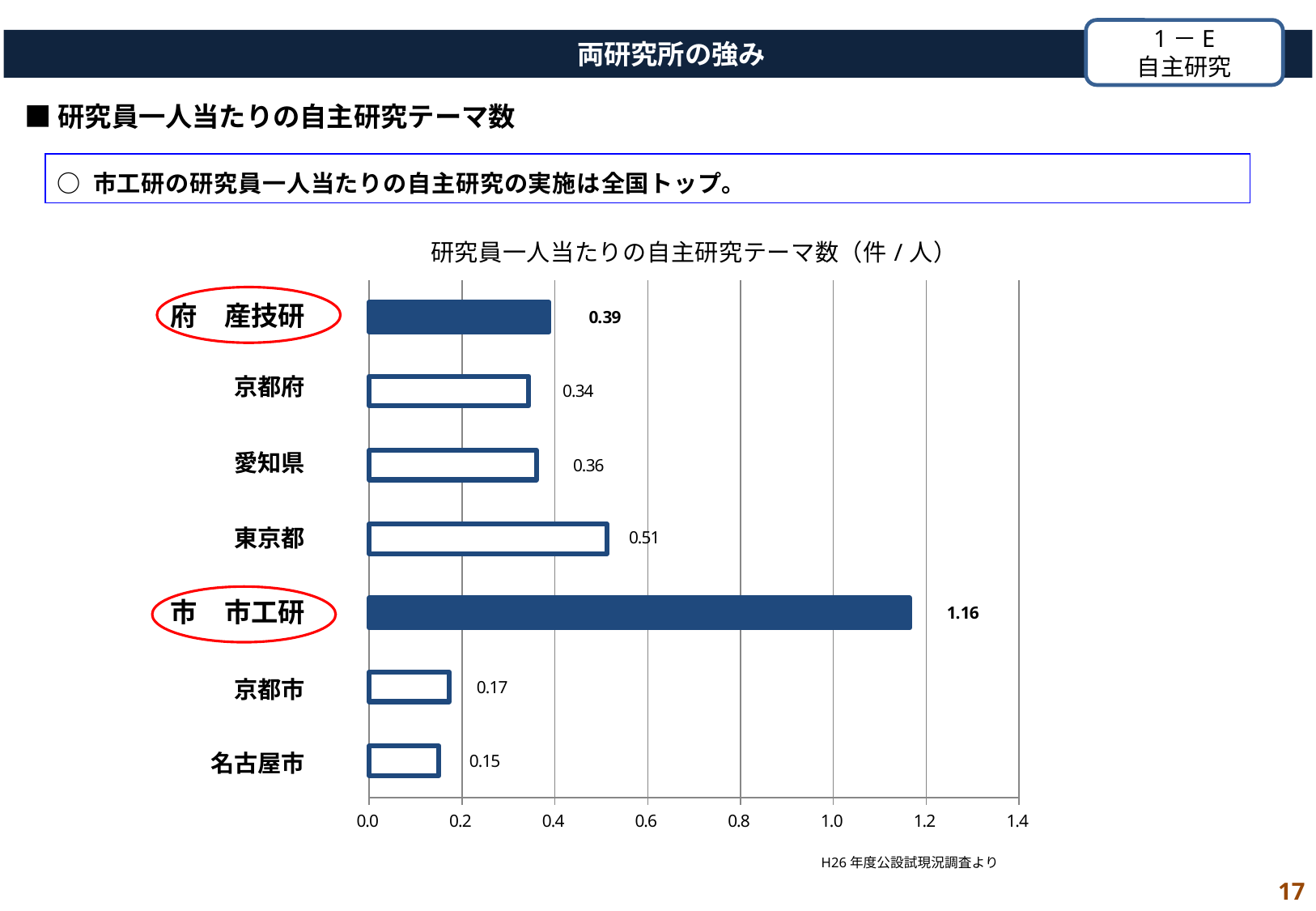
What type of chart is shown on the slide? Bar chart What is the difference between the values for 東京都 and 京都府? 0.17 How many categories are shown in the chart? 7 Which category has the lowest value in the chart? 名古屋市 What is the difference between the values for 市工研 and 産技研? 0.77 What is the value for 市工研 in the chart? 1.16 What is the value for 東京都 in the chart? 0.51 Is the value for 市工研 greater or less than 1.0? greater Which category has the highest value in the chart? 市工研 What is the value for 産技研 in the chart? 0.39 Which has a larger value, 愛知県 or 京都市? 愛知県 What is the value for 名古屋市 in the chart? 0.15